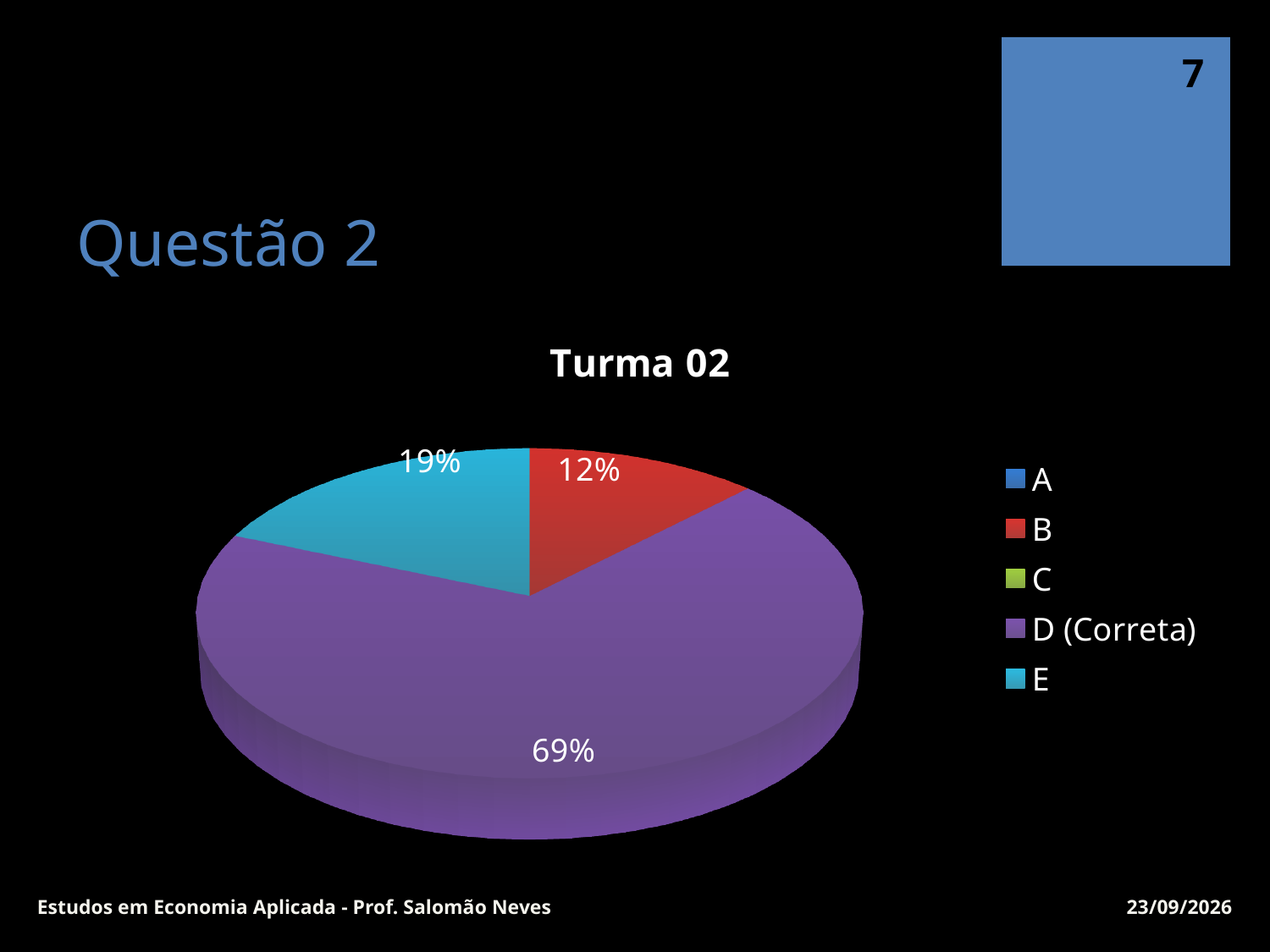
What is the title of the chart? Turma 02 What share of the pie does D (Correta) have? 69% What is the difference in percentage points between the D (Correta) slice and the E slice? 50 What kind of chart is shown on the slide? pie chart What share of the pie does E have? 19% What is the difference in percentage points between the E slice and the B slice? 7 How many entries does the legend list? 5 Which of the visible slices, B or E, is larger? E Which legend entry is marked as the correct answer? D (Correta) Which category has the largest slice of the pie? D (Correta) How many slices are visible in the pie? 3 What share of the pie does B have? 12%